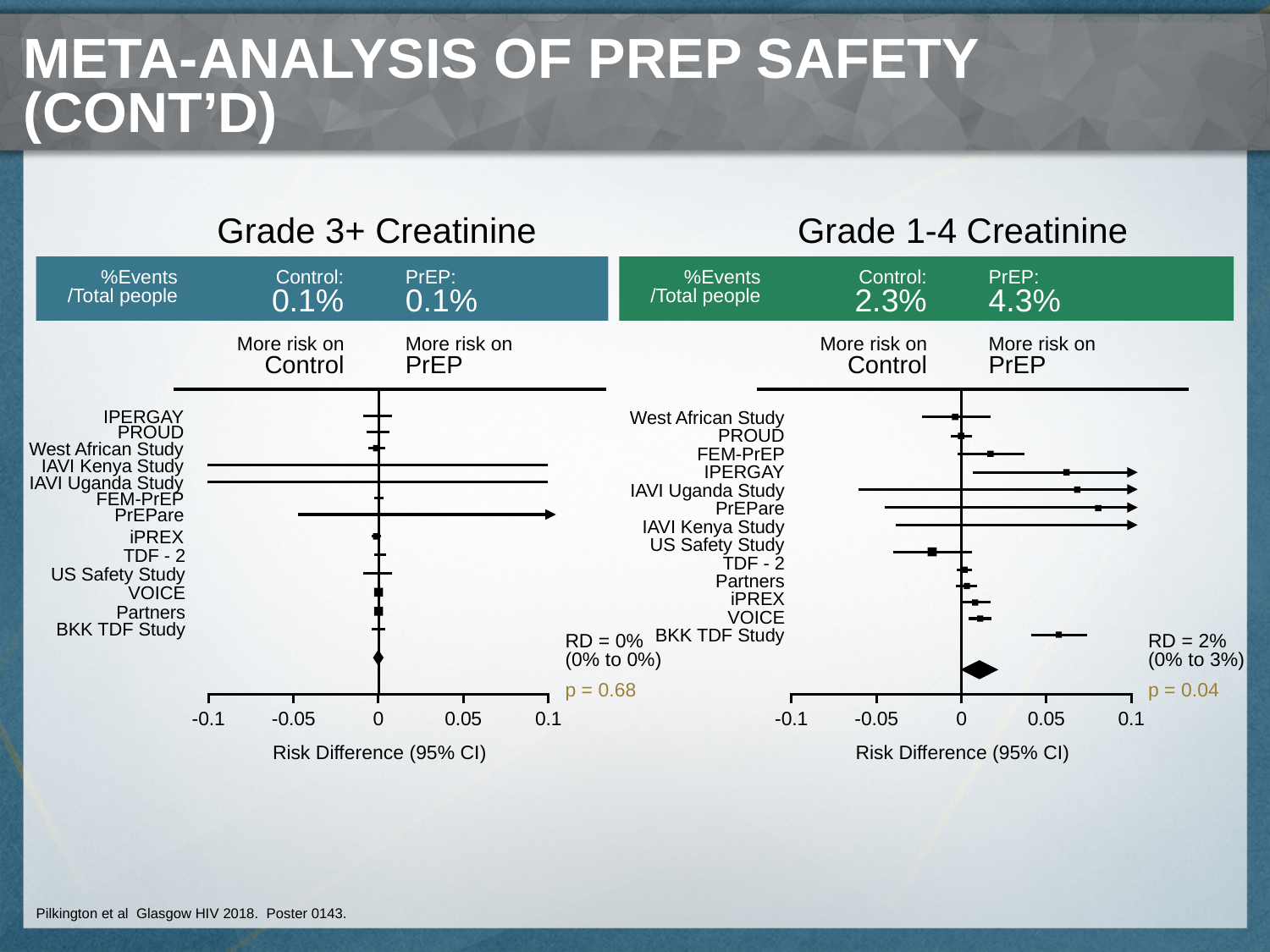
On the Grade 1-4 Creatinine chart, what is the difference between the PrEP and Control %Events/Total people? 2.0% On the Grade 1-4 Creatinine chart, what is the %Events/Total people for the Control group? 2.3% How many studies are listed on the Grade 3+ Creatinine chart? 13 On the Grade 1-4 Creatinine chart, is the risk difference point estimate for the US Safety Study greater or less than 0? less On the Grade 3+ Creatinine chart, what is the %Events/Total people for the Control group? 0.1% On the Grade 1-4 Creatinine chart, is the risk difference point estimate for the BKK TDF Study greater or less than 0? greater What p-value is shown on the Grade 1-4 Creatinine chart? p = 0.04 On the Grade 1-4 Creatinine chart, what is the %Events/Total people for the PrEP group? 4.3% What p-value is shown on the Grade 3+ Creatinine chart? p = 0.68 What is the pooled risk difference (RD) shown on the Grade 1-4 Creatinine chart? RD = 2% (0% to 3%) What is the x-axis label on the Grade 3+ Creatinine chart? Risk Difference (95% CI) On the Grade 1-4 Creatinine chart, which group has the higher %Events/Total people, Control or PrEP? PrEP